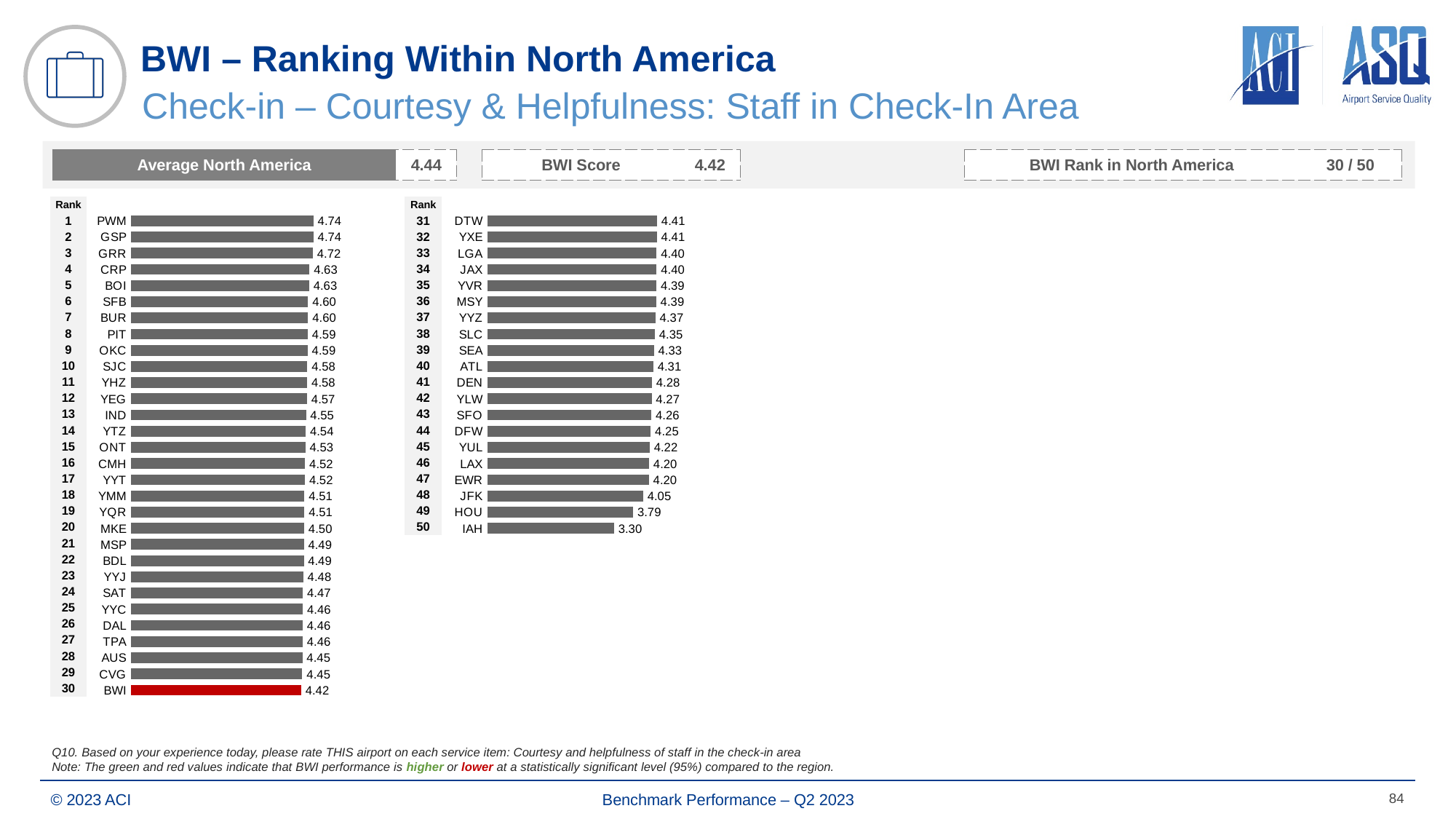
What type of chart is used on this slide to show the airport rankings? Bar chart In the right chart (ranks 31-50), which is larger, the value for HOU or the value for JFK? JFK How many airports are plotted in the right chart (ranks 31-50)? 20 In the left chart (ranks 1-30), what is the value for BWI? 4.42 In the right chart (ranks 31-50), which airport has the lowest value? IAH What is the difference between the value for PWM in the left chart and the value for IAH in the right chart? 1.44 How many airports are plotted in the left chart (ranks 1-30)? 30 In the right chart (ranks 31-50), what is the value for IAH? 3.30 In the right chart (ranks 31-50), what is the value for JFK? 4.05 In the left chart (ranks 1-30), which airport has the lowest value? BWI In the left chart (ranks 1-30), what is the value for GRR? 4.72 In the right chart (ranks 31-50), which airport has the highest value? DTW and YXE (tied at 4.41)